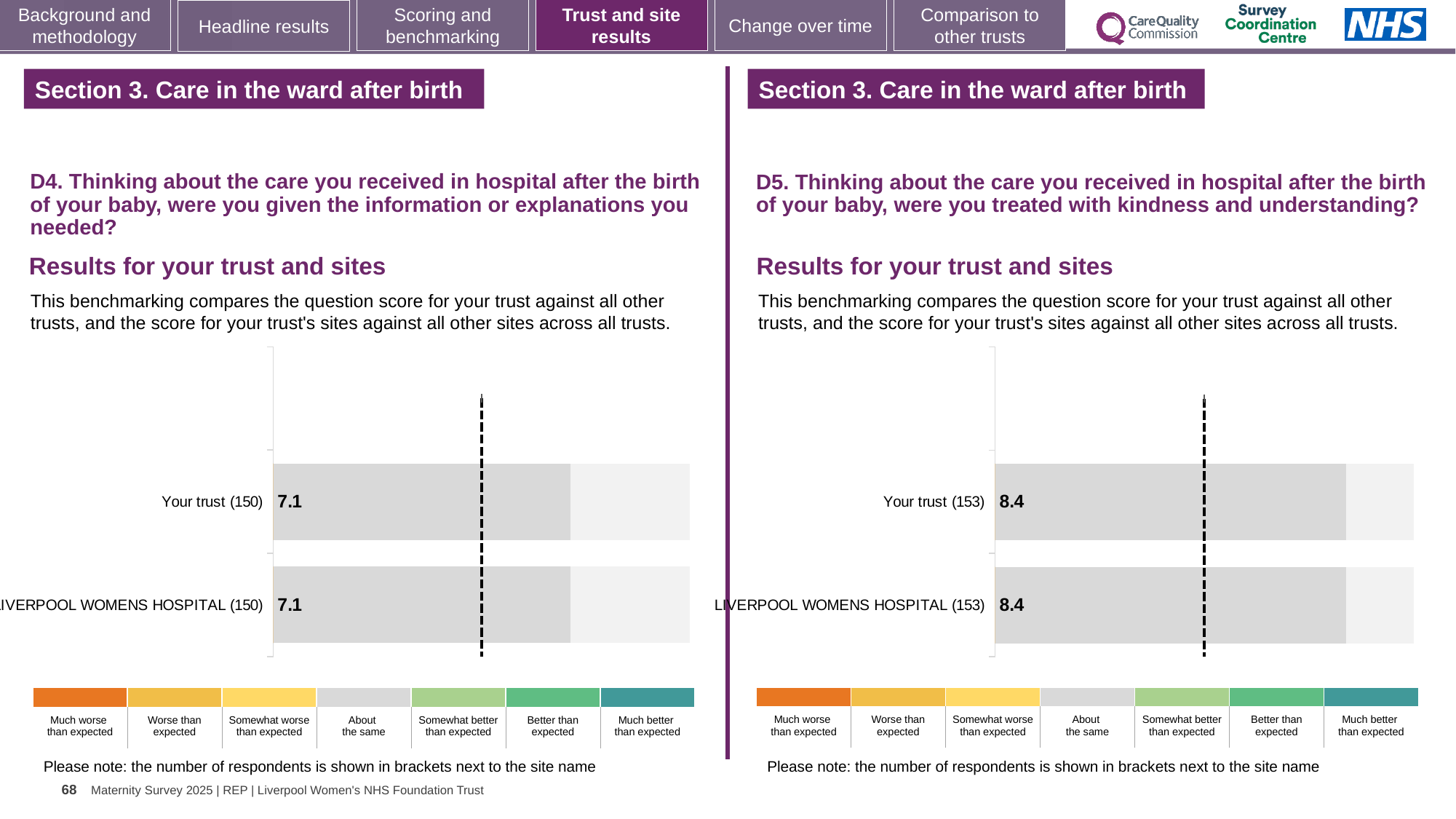
On the left chart (D4), how many respondents are shown in brackets for Your trust? 150 On the right chart (D5), what is the score for LIVERPOOL WOMENS HOSPITAL? 8.4 How many categories does the colour legend below the left chart (D4) list? 7 How many bars are plotted on the right chart (D5)? 2 On the left chart (D4), what is the score for LIVERPOOL WOMENS HOSPITAL? 7.1 On the left chart (D4), what is the difference between the score for Your trust and the score for LIVERPOOL WOMENS HOSPITAL? 0.0 On the right chart (D5), what is the score for Your trust? 8.4 On the left chart (D4), what is the score for Your trust? 7.1 On the right chart (D5), how many respondents are shown in brackets for LIVERPOOL WOMENS HOSPITAL? 153 What kind of chart is used on the left (D4) to show the results for your trust and sites? Bar chart On the right chart (D5), which legend category does the colour of the Your trust bar correspond to? About the same Which is larger: the Your trust score on the left chart (D4) or the Your trust score on the right chart (D5)? The right chart (D5), 8.4